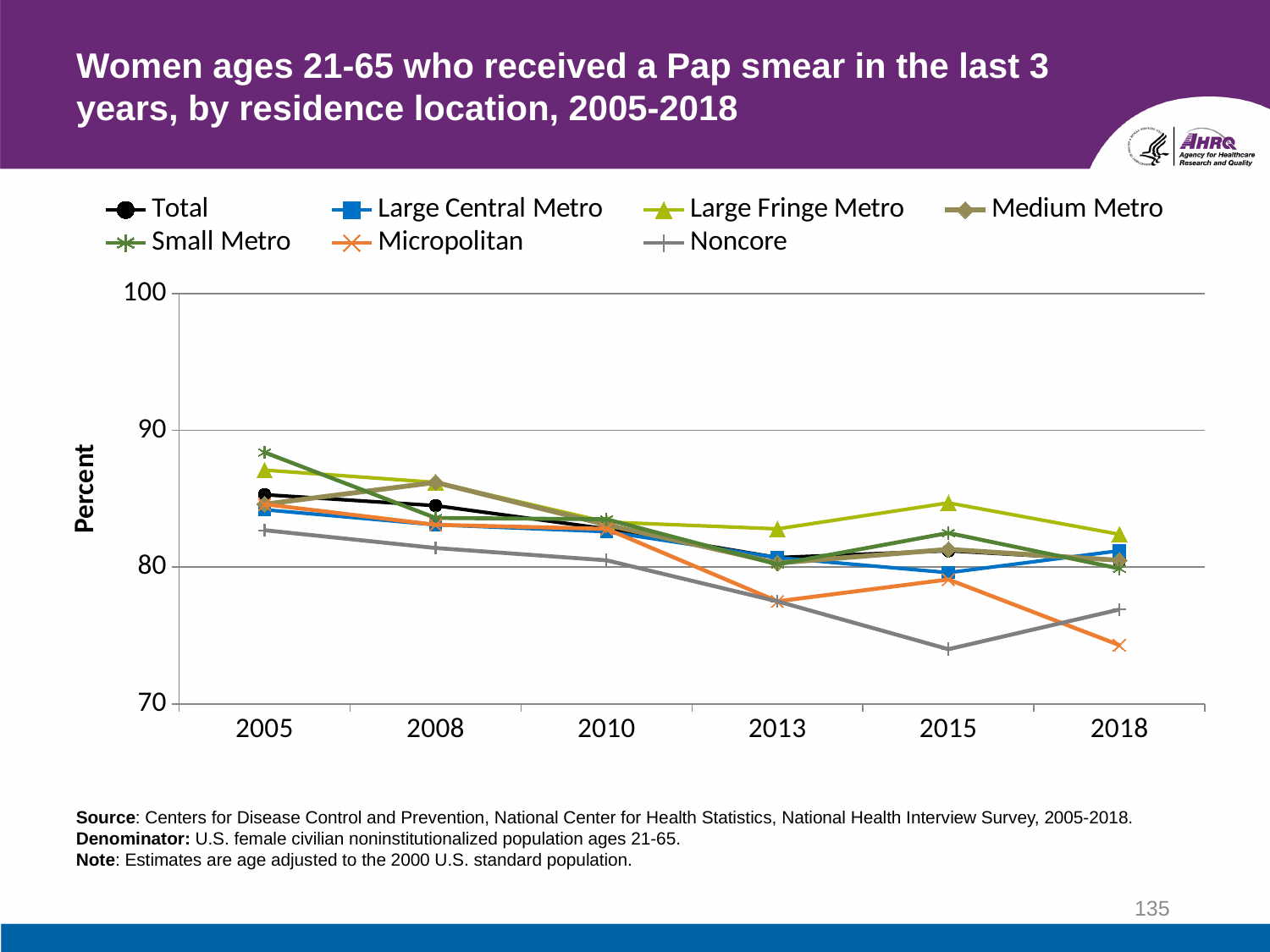
Does the Noncore line rise or fall from 2005 to 2015? fall In 2018, which is larger, the value for Noncore or the value for Micropolitan? Noncore Is the value for Noncore in 2015 greater or less than 80? less Is the value for Micropolitan in 2018 greater or less than 80? less Which residence location has the lowest value in 2018? Micropolitan What is the label on the vertical axis? Percent How many years are plotted along the x axis? 6 Is the value for Large Fringe Metro in 2015 greater or less than 80? greater What kind of chart is shown on the slide? line chart How many series does the legend list? 7 Which residence location has the lowest value in 2015? Noncore